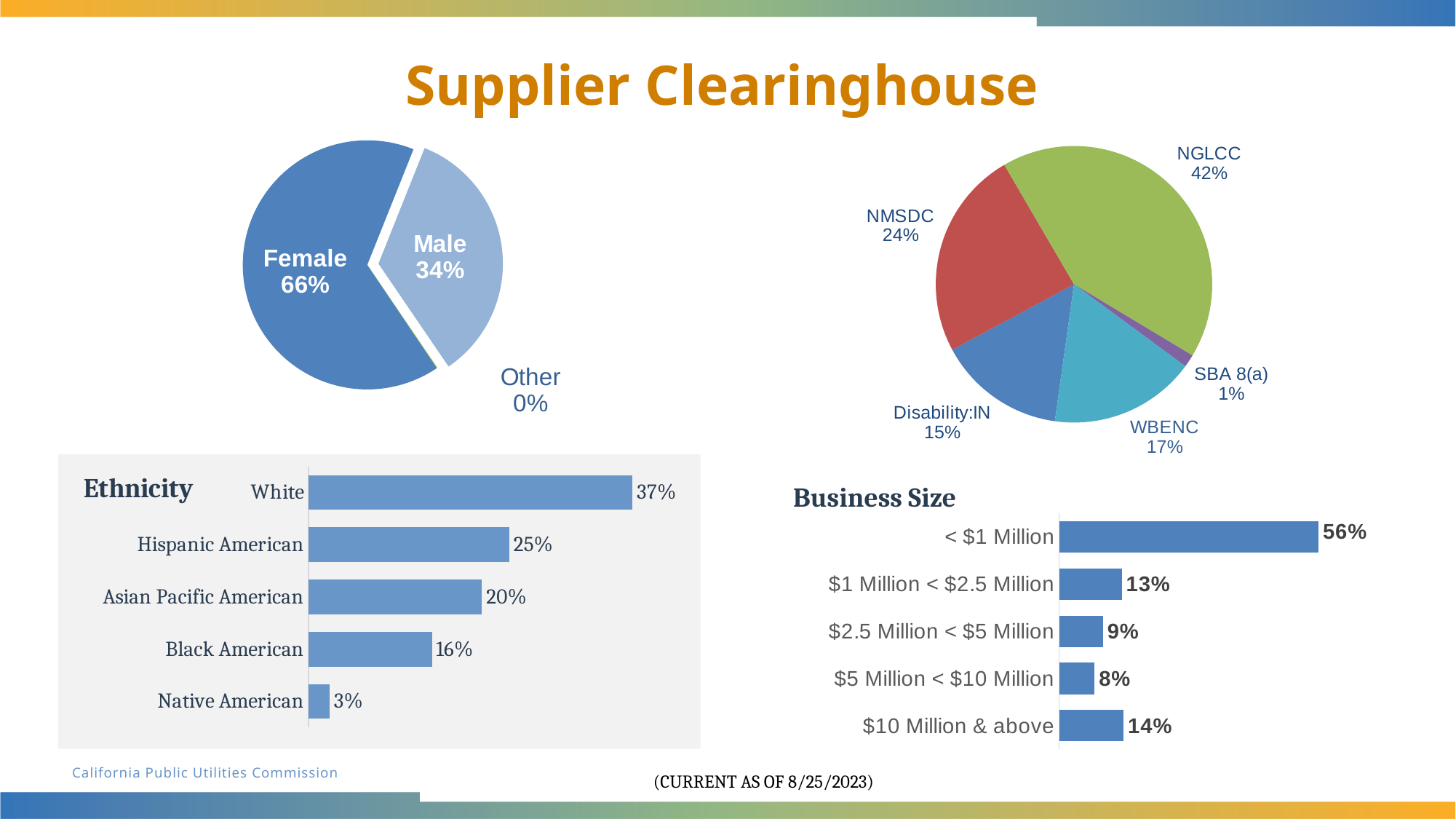
In the certification pie chart at the top right, what is the share for NMSDC? 24% In the Business Size chart, what is the value for $10 Million & above? 14% In the certification pie chart at the top right, what is the difference between the NGLCC and WBENC shares? 25% In the gender pie chart at the top left, what share is Female? 66% What kind of chart is the Business Size chart? Bar chart In the Ethnicity chart, which category has the lowest value? Native American In the certification pie chart at the top right, which category has the smallest share? SBA 8(a) In the Ethnicity chart, how many categories are shown? 5 In the Ethnicity chart, what is the value for Asian Pacific American? 20% In the Business Size chart, which is larger: $1 Million < $2.5 Million or $2.5 Million < $5 Million? $1 Million < $2.5 Million In the certification pie chart at the top right, which category has the largest share? NGLCC In the gender pie chart at the top left, what share is Male? 34%